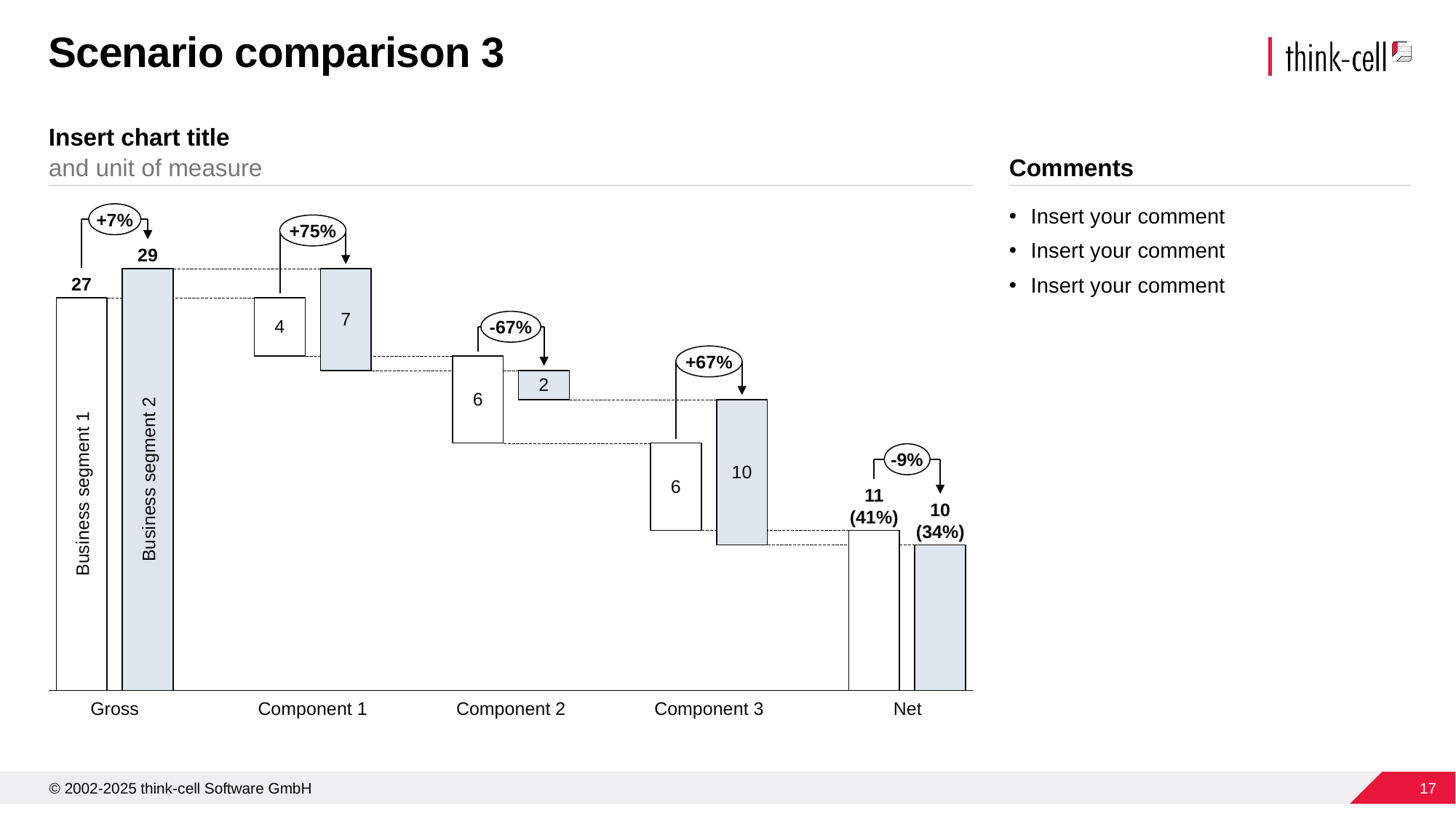
How many categories are shown on the x axis? 5 What is the Component 1 value for Business segment 2? 7 What percentage change is shown between the two segments for Net? -9% What is the Component 2 value for Business segment 2? 2 Which segment has the larger Component 2 value, Business segment 1 or Business segment 2? Business segment 1 What kind of chart is shown on the slide? Waterfall chart What percentage change is shown between the two segments for Component 3? +67% What is the Gross value for Business segment 2? 29 What is the Gross value for Business segment 1? 27 What is the Net value label for Business segment 1? 11 (41%) Which category has the highest value for Business segment 2? Gross What is the difference between the Gross values of Business segment 2 and Business segment 1? 2